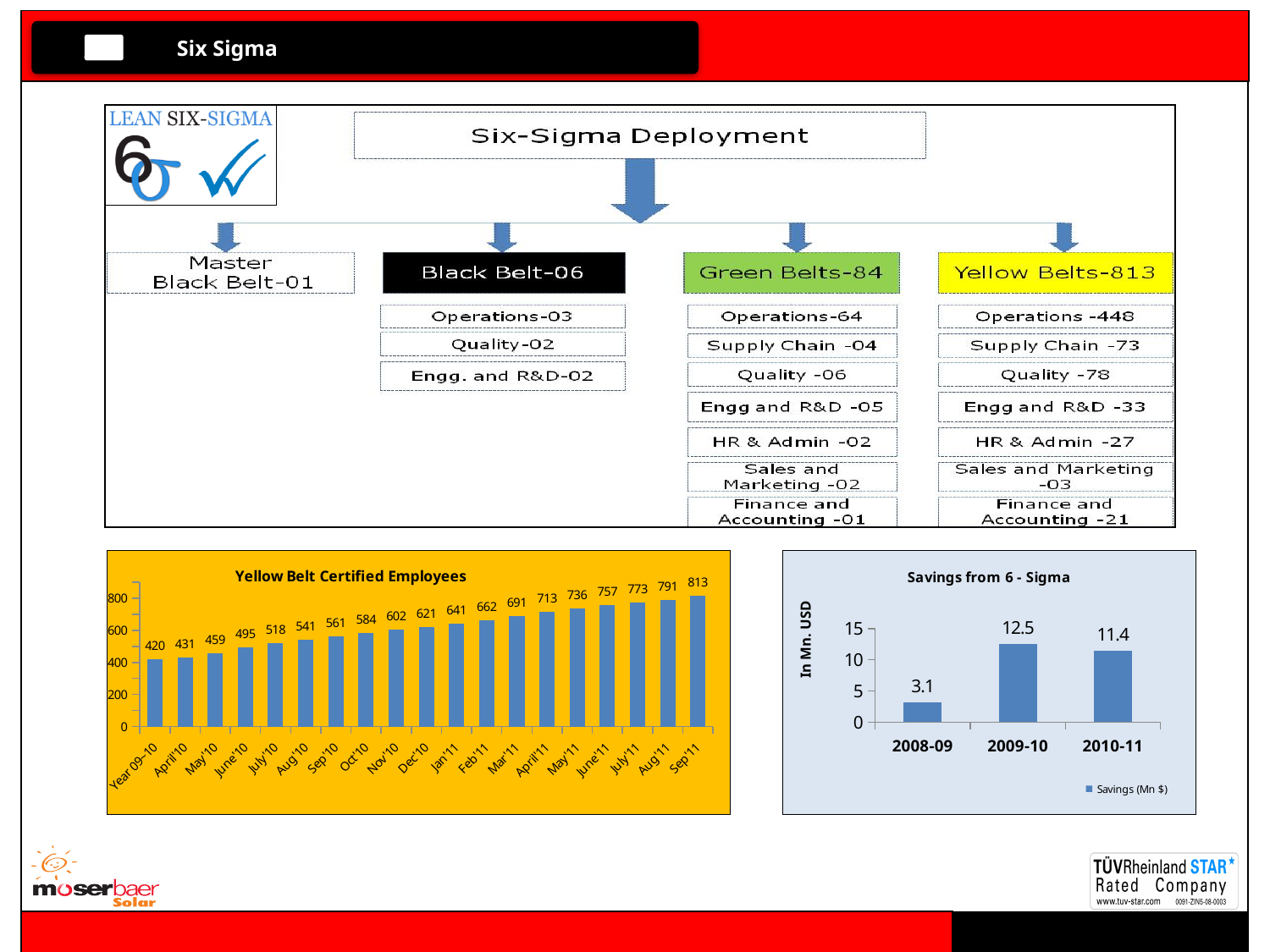
In the 'Savings from 6 - Sigma' chart, what is the difference between the 2009-10 and 2010-11 values? 1.1 What kind of chart is the 'Yellow Belt Certified Employees' chart? bar chart In the 'Yellow Belt Certified Employees' chart, what is the value for Dec'10? 621 In the 'Yellow Belt Certified Employees' chart, do the values rise or fall from left to right along the x axis? rise In the 'Yellow Belt Certified Employees' chart, what is the difference between the Sep'11 and Year 09-10 values? 393 In the 'Savings from 6 - Sigma' chart, what is the value for 2009-10? 12.5 In the 'Savings from 6 - Sigma' chart, what is the y-axis label? In Mn. USD In the 'Yellow Belt Certified Employees' chart, what is the value for Sep'11? 813 In the 'Savings from 6 - Sigma' chart, how many series does the legend list? 1 In the 'Yellow Belt Certified Employees' chart, which category has the highest value? Sep'11 In the 'Savings from 6 - Sigma' chart, which year has the lowest savings? 2008-09 In the 'Savings from 6 - Sigma' chart, what is the value for 2008-09? 3.1